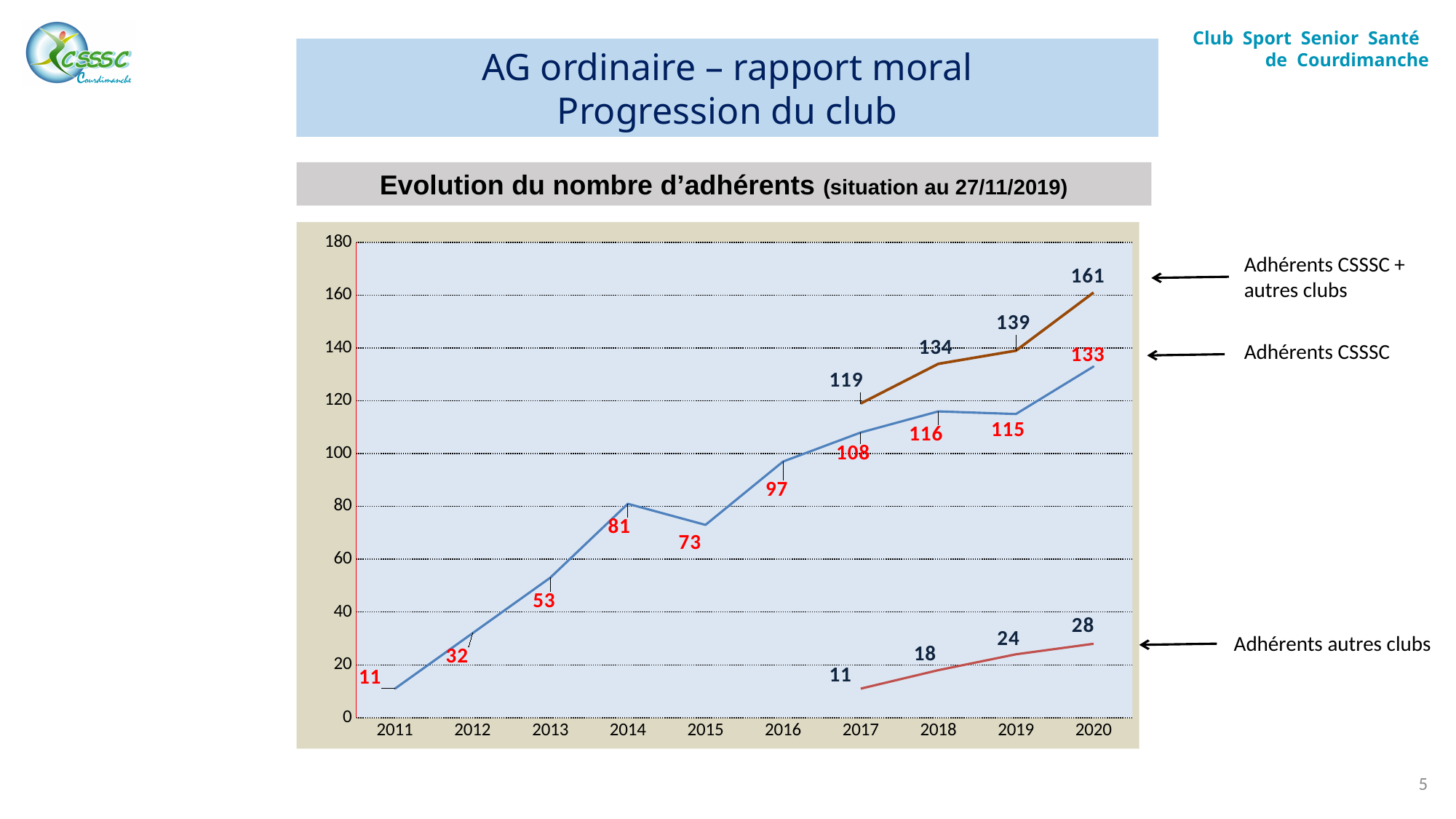
What is the number of Adhérents CSSSC in 2014? 81 What is the value for Adhérents CSSSC + autres clubs in 2020? 161 Does the number of Adhérents autres clubs rise or fall from 2017 to 2020? rise In which year is the number of Adhérents CSSSC the highest? 2020 In which year is the number of Adhérents CSSSC the lowest? 2011 What kind of chart is shown on the slide? line chart What is the value for Adhérents autres clubs in 2018? 18 How many years are shown on the x axis? 10 What is the difference between Adhérents CSSSC in 2020 and in 2019? 18 Which is larger: Adhérents CSSSC in 2014 or in 2015? 2014 What is the title of the chart? Evolution du nombre d'adhérents (situation au 27/11/2019) How many series are plotted on the chart? 3